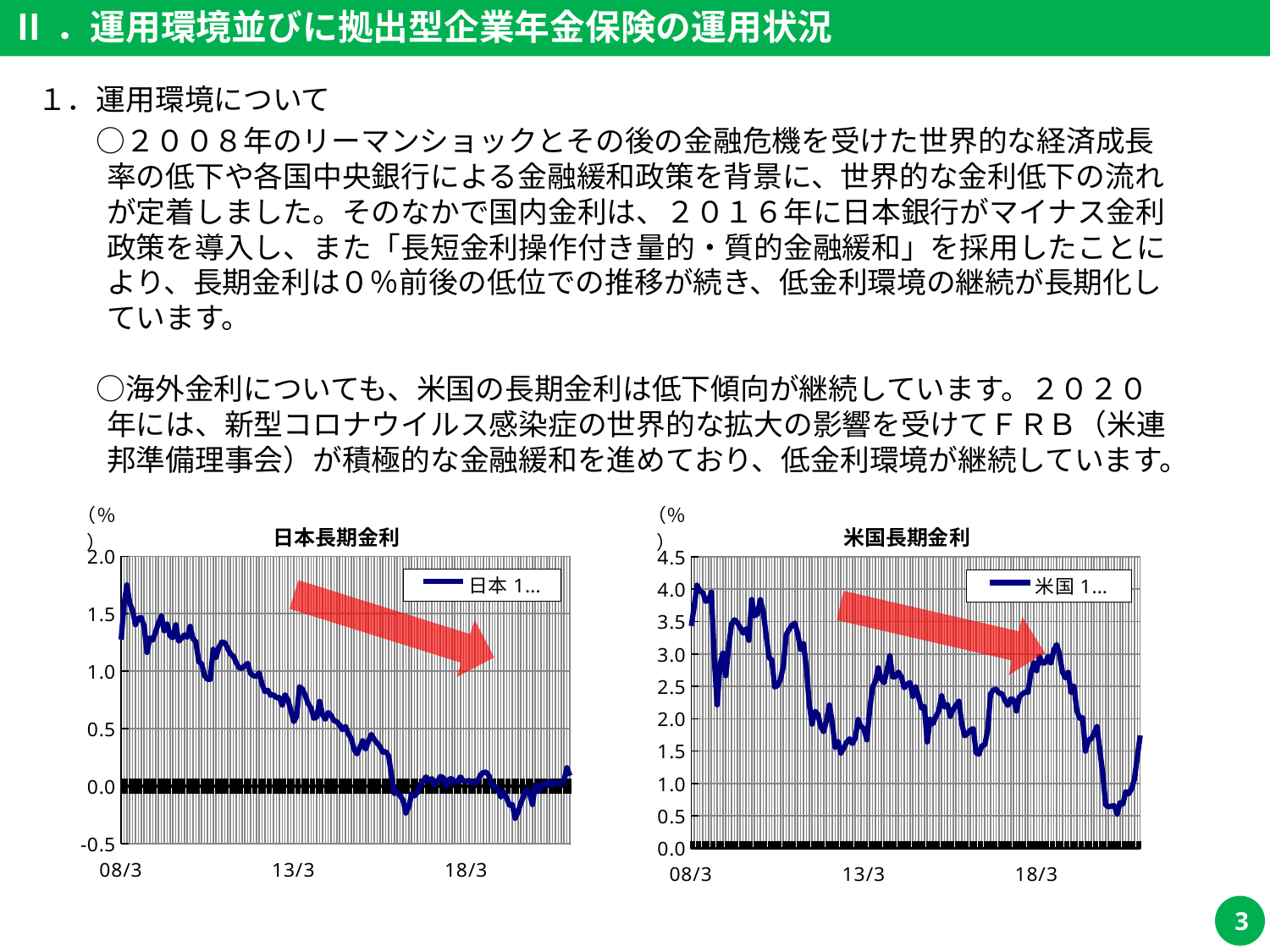
In the 米国長期金利 chart, is the value at 18/3 greater or less than 2.0? greater How many series does the legend of the 日本長期金利 chart list? 1 What kind of chart is the 米国長期金利 chart? line chart How many series does the legend of the 米国長期金利 chart list? 1 What is the highest value shown on the vertical axis of the 米国長期金利 chart? 4.5 In the 米国長期金利 chart, is the value at 08/3 greater or less than 3.0? greater In the 米国長期金利 chart, do the values generally rise or fall from 08/3 to the end of the period? fall In the 日本長期金利 chart, is the value at 08/3 greater or less than 1.0? greater In the 日本長期金利 chart, do the values generally rise or fall from 08/3 to the end of the period? fall What is the title of the chart on the left side of the slide? 日本長期金利 What kind of chart is the 日本長期金利 chart? line chart